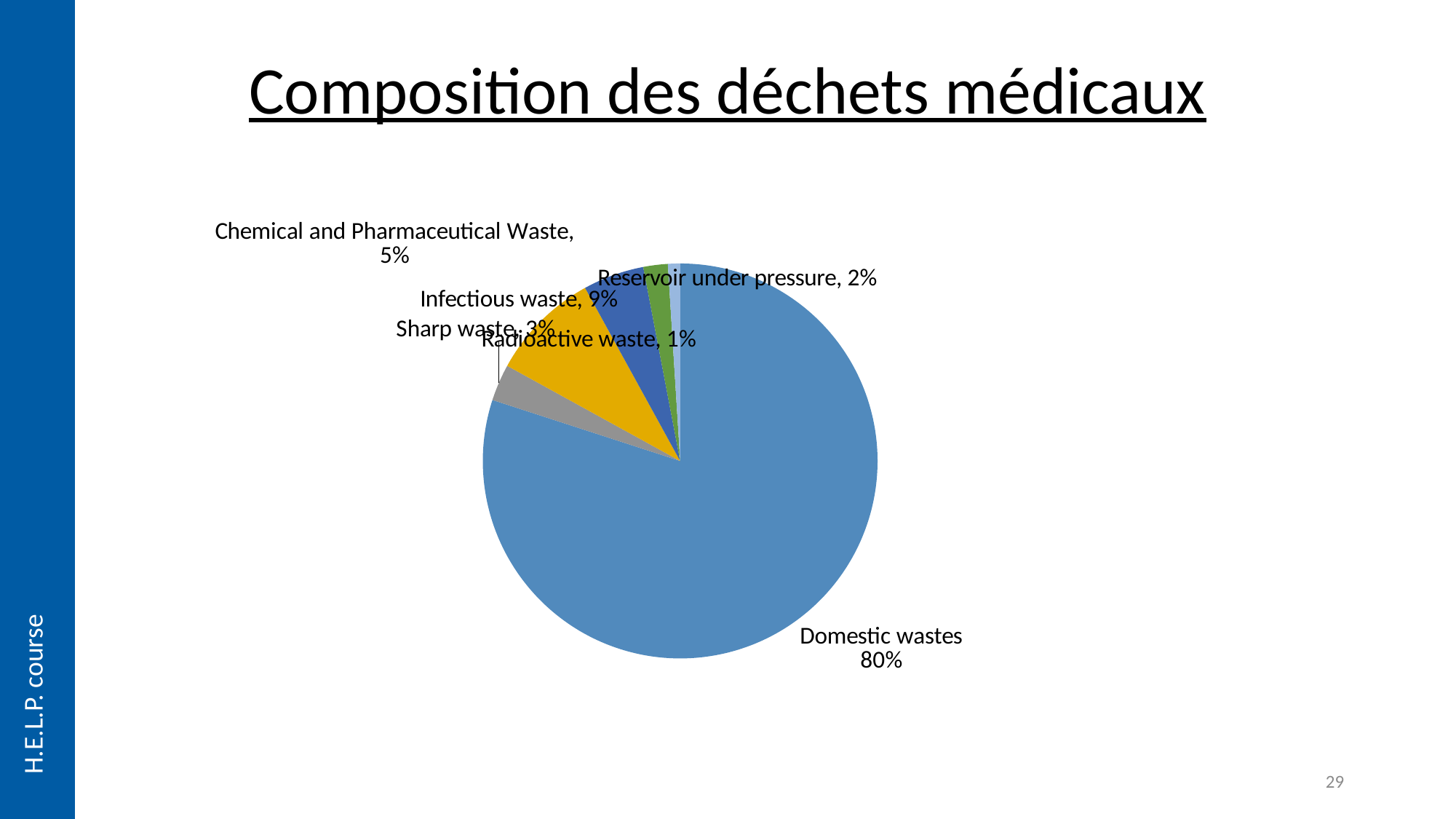
What kind of chart is shown on the slide? Pie chart What is the difference in percentage points between Infectious waste and Sharp waste? 6 What percentage is shown for Infectious waste? 9% Which category has the largest share of the pie? Domestic wastes How many slices does the pie chart have? 6 Which category has the smallest share of the pie? Radioactive waste What is the title of the slide containing the pie chart? Composition des déchets médicaux What percentage is shown for Sharp waste? 3% What share of the pie is Domestic wastes? 80% Which is larger, Chemical and Pharmaceutical Waste or Reservoir under pressure? Chemical and Pharmaceutical Waste What percentage is shown for Chemical and Pharmaceutical Waste? 5% What percentage is shown for Reservoir under pressure? 2%